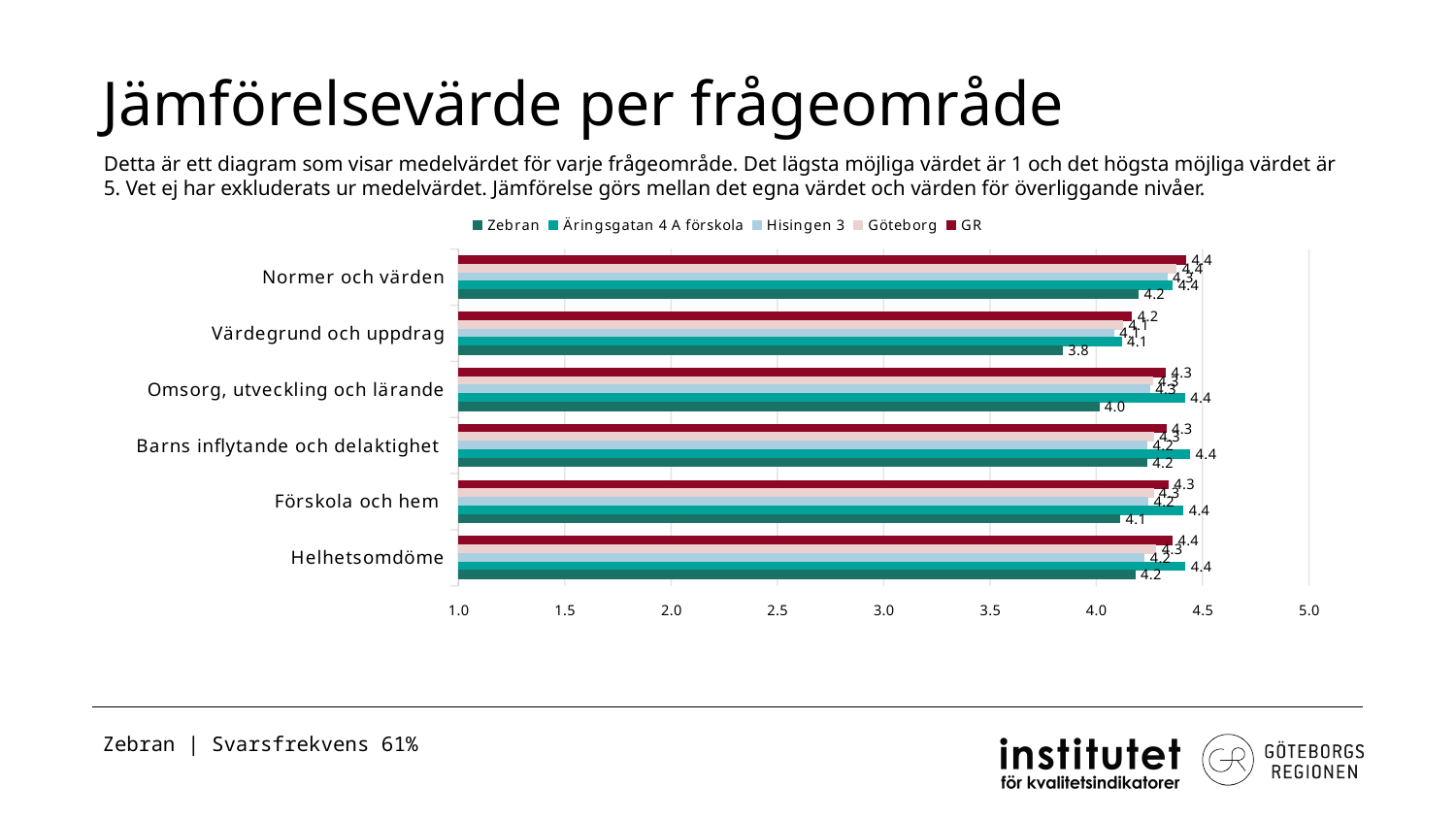
What is the difference between the Äringsgatan 4 A förskola value and the Zebran value in the category Omsorg, utveckling och lärande? 0.4 What kind of chart is shown on the slide? Bar chart How many series does the legend of the chart list? 5 What is the title of the chart on the slide? Jämförelsevärde per frågeområde Which is larger in the category Värdegrund och uppdrag: the value for Zebran or the value for GR? GR How many categories (question areas) are shown on the y axis of the chart? 6 Is the value for Zebran in the category Värdegrund och uppdrag greater or less than 4.0? less What is the value for Zebran in the category Omsorg, utveckling och lärande? 4.0 What is the value for Zebran in the category Värdegrund och uppdrag? 3.8 Which category has the lowest value for Zebran? Värdegrund och uppdrag What is the value for Zebran in the category Förskola och hem? 4.1 What is the value for Äringsgatan 4 A förskola in the category Helhetsomdöme? 4.4